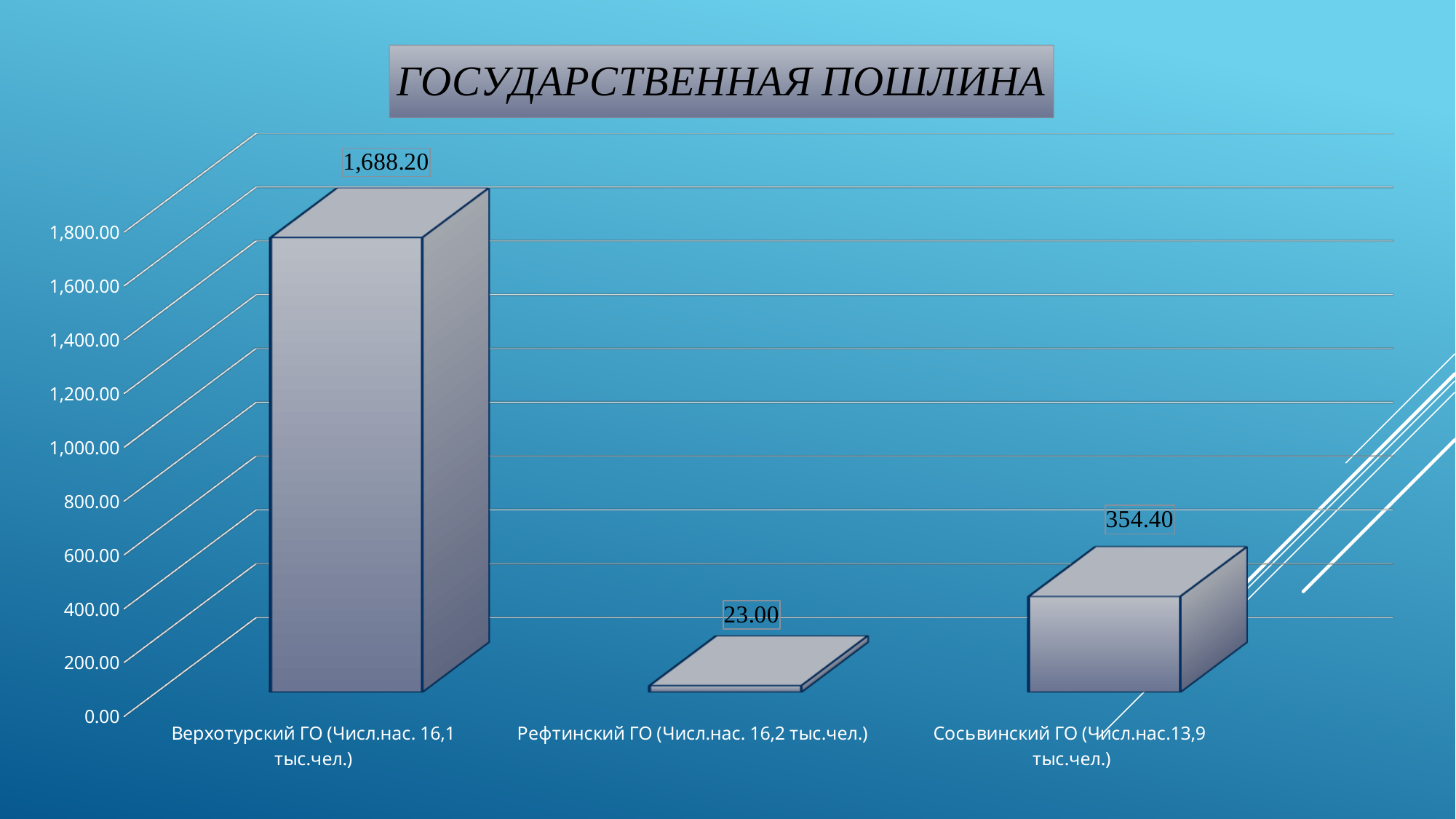
Which category has the highest value? Верхотурский ГО What is the difference between the values for Сосьвинский ГО and Рефтинский ГО? 331.40 What is the value for Рефтинский ГО? 23.00 How many categories are shown on the chart? 3 What kind of chart is shown on the slide? bar chart What is the value for Сосьвинский ГО? 354.40 Is the value for Сосьвинский ГО greater or less than 400.00? less What is the title of the chart? ГОСУДАРСТВЕННАЯ ПОШЛИНА Which is larger, the value for Сосьвинский ГО or the value for Рефтинский ГО? Сосьвинский ГО What is the value for Верхотурский ГО? 1,688.20 What is the difference between the values for Верхотурский ГО and Сосьвинский ГО? 1,333.80 Which category has the lowest value? Рефтинский ГО